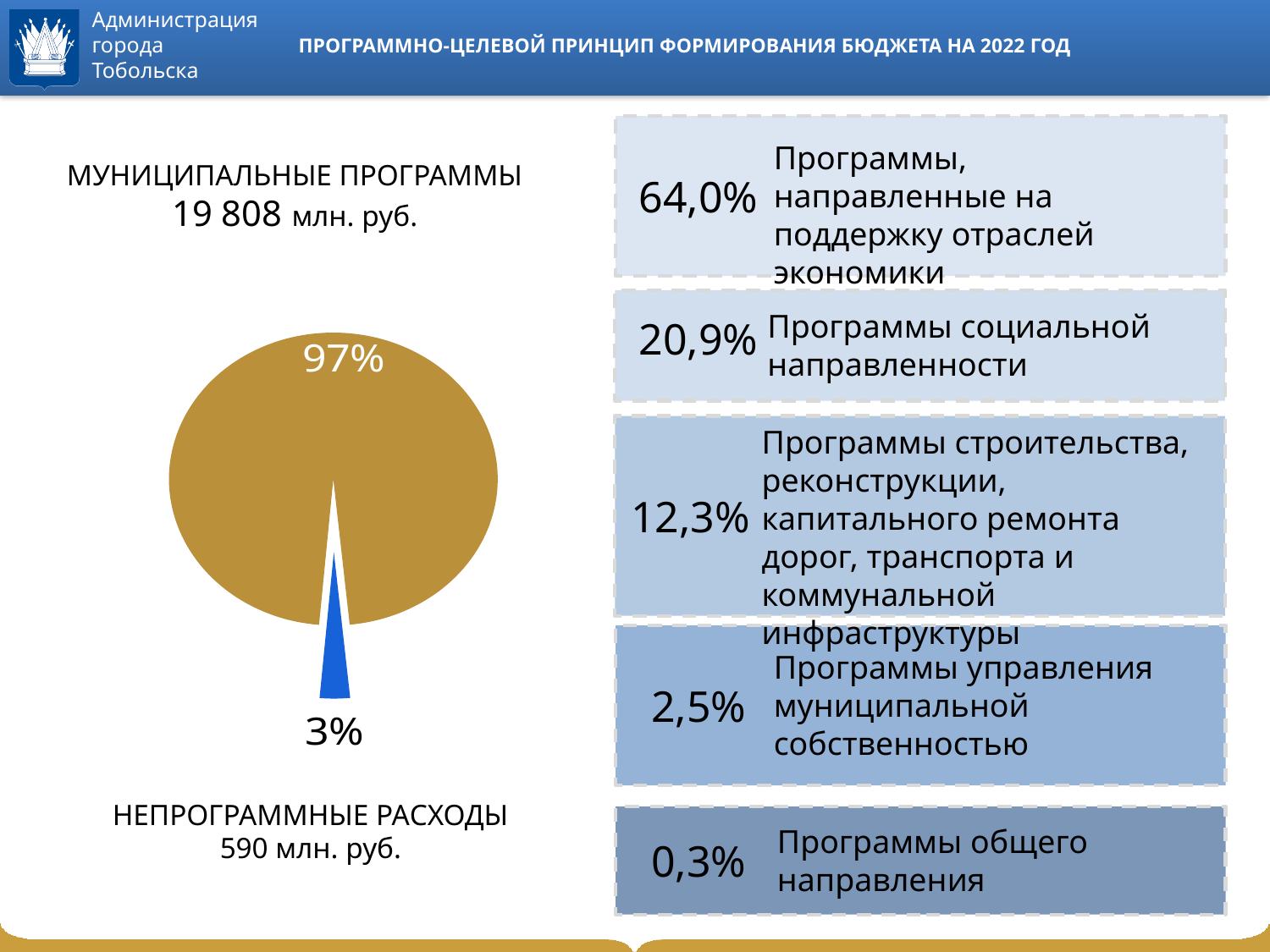
Which slice of the pie chart is the smallest? НЕПРОГРАММНЫЕ РАСХОДЫ (3%) What amount in млн. руб. is shown for МУНИЦИПАЛЬНЫЕ ПРОГРАММЫ above the pie chart? 19 808 млн. руб. What share of the pie chart do МУНИЦИПАЛЬНЫЕ ПРОГРАММЫ take? 97% What is the difference in percentage points between the two slices of the pie chart? 94 What colour is the 3% slice of the pie chart? blue How many slices does the pie chart have? 2 What share of the pie chart is labelled 97%? МУНИЦИПАЛЬНЫЕ ПРОГРАММЫ Which slice of the pie chart is the largest? МУНИЦИПАЛЬНЫЕ ПРОГРАММЫ (97%) What kind of chart is shown on the left of the slide? pie chart What share of the pie chart do НЕПРОГРАММНЫЕ РАСХОДЫ take? 3% What amount in млн. руб. is shown for НЕПРОГРАММНЫЕ РАСХОДЫ below the pie chart? 590 млн. руб. Which is larger in the pie chart: МУНИЦИПАЛЬНЫЕ ПРОГРАММЫ or НЕПРОГРАММНЫЕ РАСХОДЫ? МУНИЦИПАЛЬНЫЕ ПРОГРАММЫ